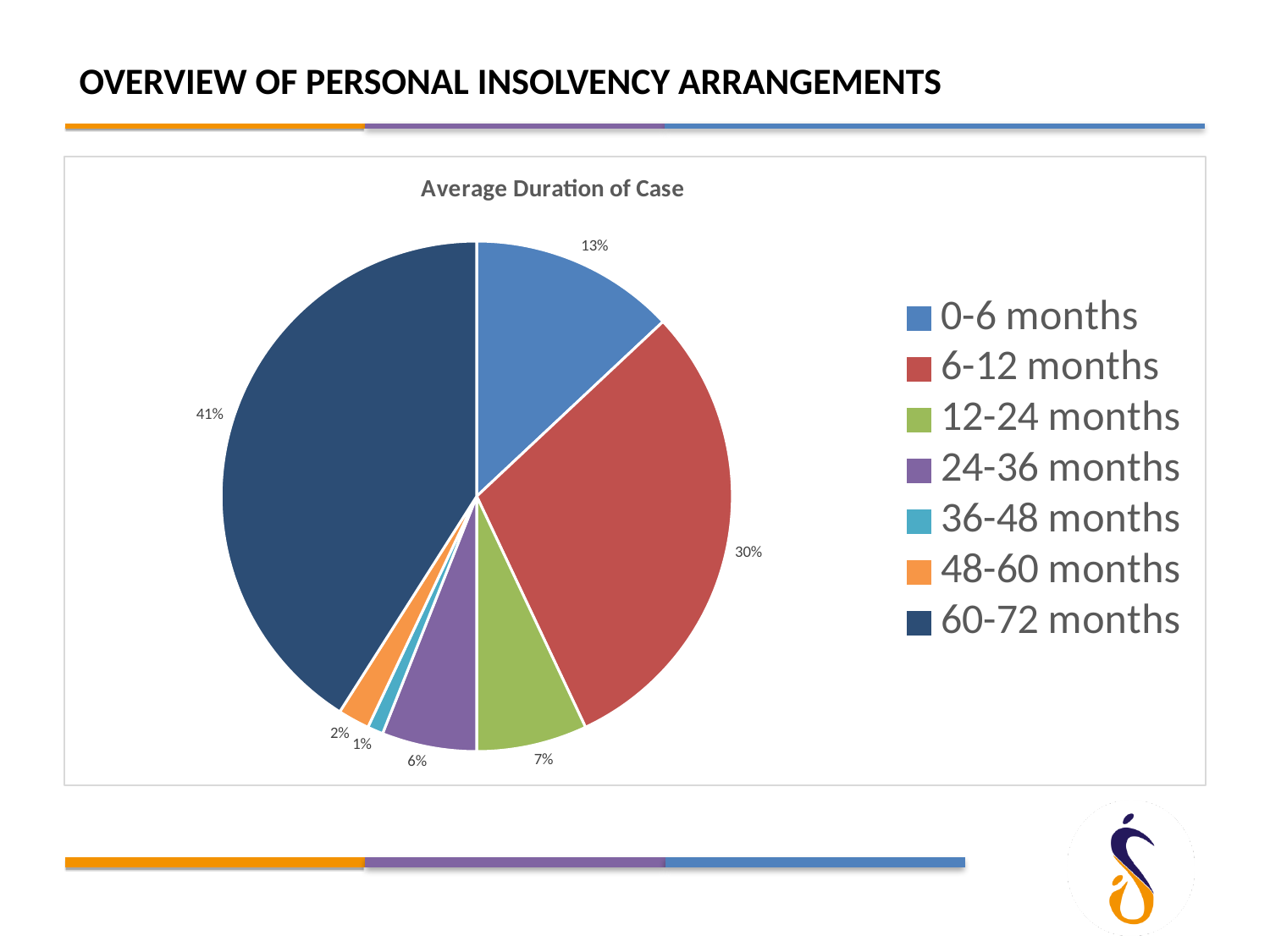
What share of cases have an average duration of 12-24 months? 7% What is the difference in percentage points between the 60-72 months share and the 6-12 months share? 11 What is the title of the chart? Average Duration of Case What share of cases have an average duration of 36-48 months? 1% Which duration category has the smallest share of the pie? 36-48 months Which is larger, the share for 12-24 months or the share for 24-36 months? 12-24 months What share of cases have an average duration of 6-12 months? 30% What kind of chart is shown on the slide? Pie chart Which duration category has the largest share of the pie? 60-72 months How many duration categories does the legend list? 7